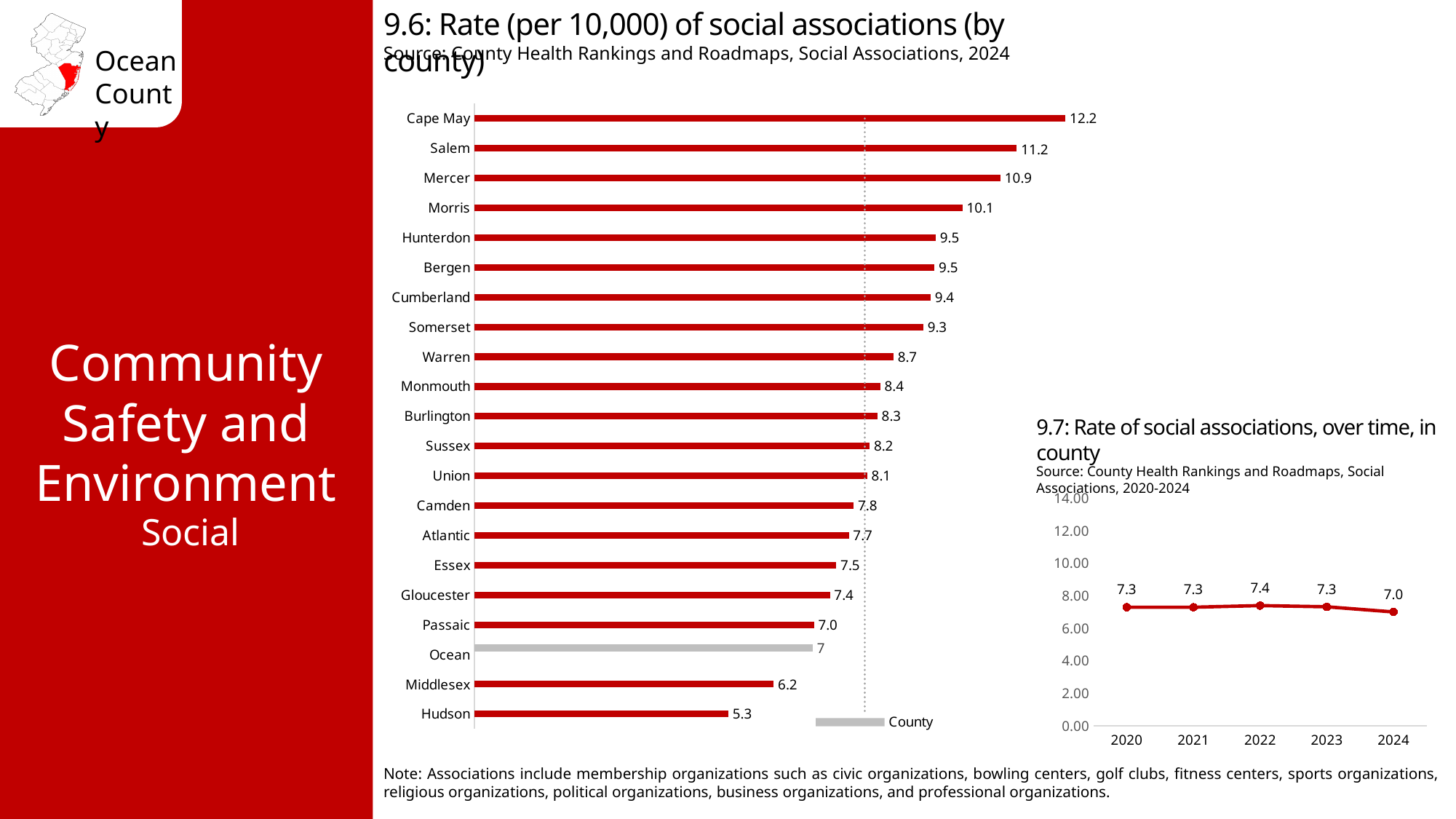
How many data points are plotted in the chart '9.7: Rate of social associations, over time, in county'? 5 In the chart '9.6: Rate (per 10,000) of social associations (by county)', what is the difference between the values for Salem and Middlesex? 5.0 In the chart '9.6: Rate (per 10,000) of social associations (by county)', what is the value for Ocean? 7 In the chart '9.7: Rate of social associations, over time, in county', what is the value for 2022? 7.4 In the chart '9.6: Rate (per 10,000) of social associations (by county)', which county has the highest rate? Cape May In the chart '9.6: Rate (per 10,000) of social associations (by county)', which has a higher value, Morris or Warren? Morris In the chart '9.6: Rate (per 10,000) of social associations (by county)', what is the value for Cape May? 12.2 In the chart '9.7: Rate of social associations, over time, in county', what is the value for 2024? 7.0 What kind of chart is '9.7: Rate of social associations, over time, in county'? Line chart How many counties are shown in the chart '9.6: Rate (per 10,000) of social associations (by county)'? 21 What kind of chart is '9.6: Rate (per 10,000) of social associations (by county)'? Bar chart In the chart '9.6: Rate (per 10,000) of social associations (by county)', which county has the lowest rate? Hudson